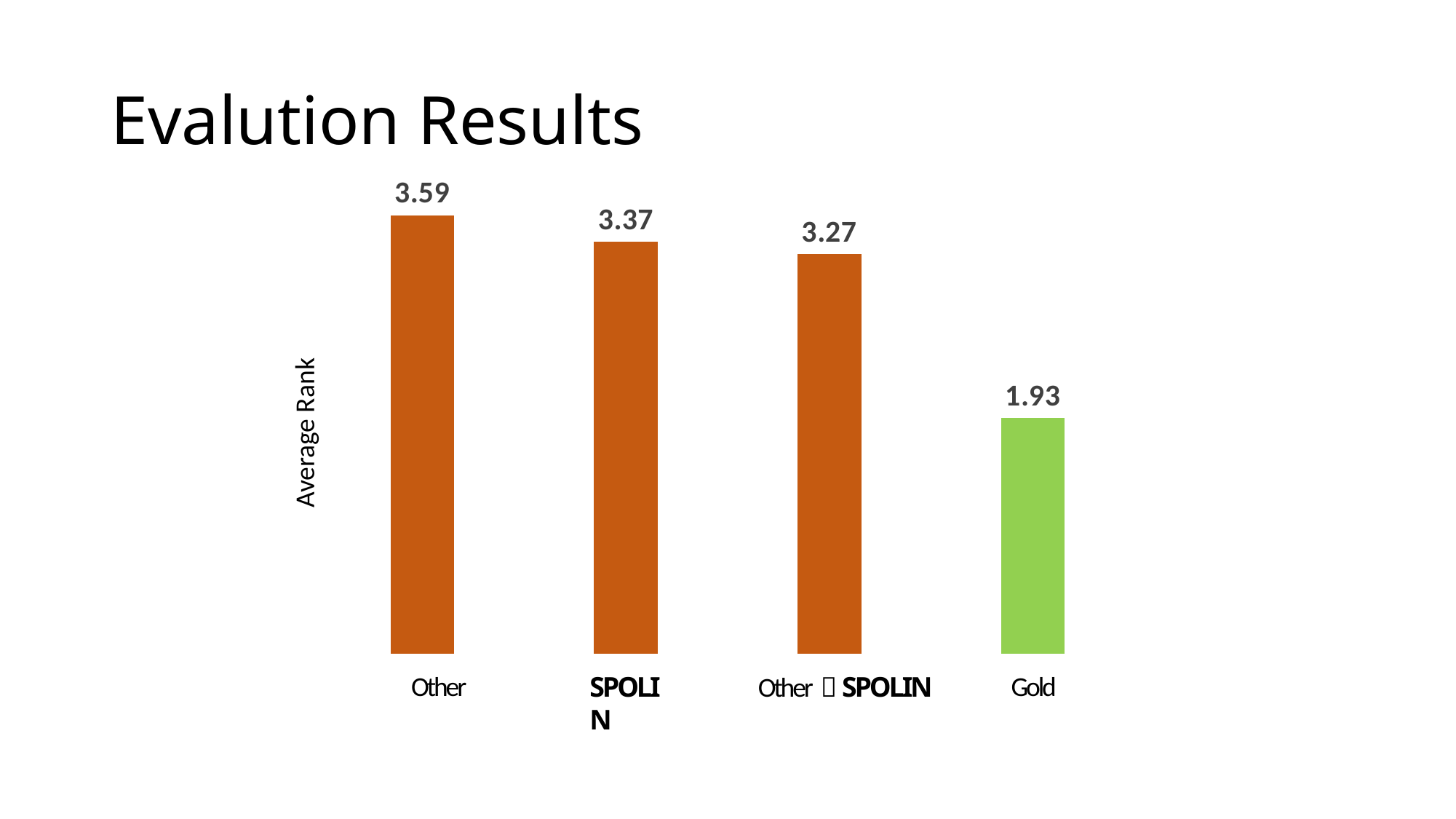
What is the label on the vertical axis of the chart? Average Rank What is the difference between the average rank for Other and for SPOLIN? 0.22 What value is shown on the third bar from the left? 3.27 What is the average rank for Gold? 1.93 What is the average rank for Other? 3.59 How many bars are shown in the chart? 4 What is the difference between the average rank for SPOLIN and for Gold? 1.44 Which category has the lowest average rank? Gold Which category has the highest average rank? Other What is the average rank for SPOLIN? 3.37 What kind of chart is shown on the slide? Bar chart Which has a higher average rank, SPOLIN or Gold? SPOLIN